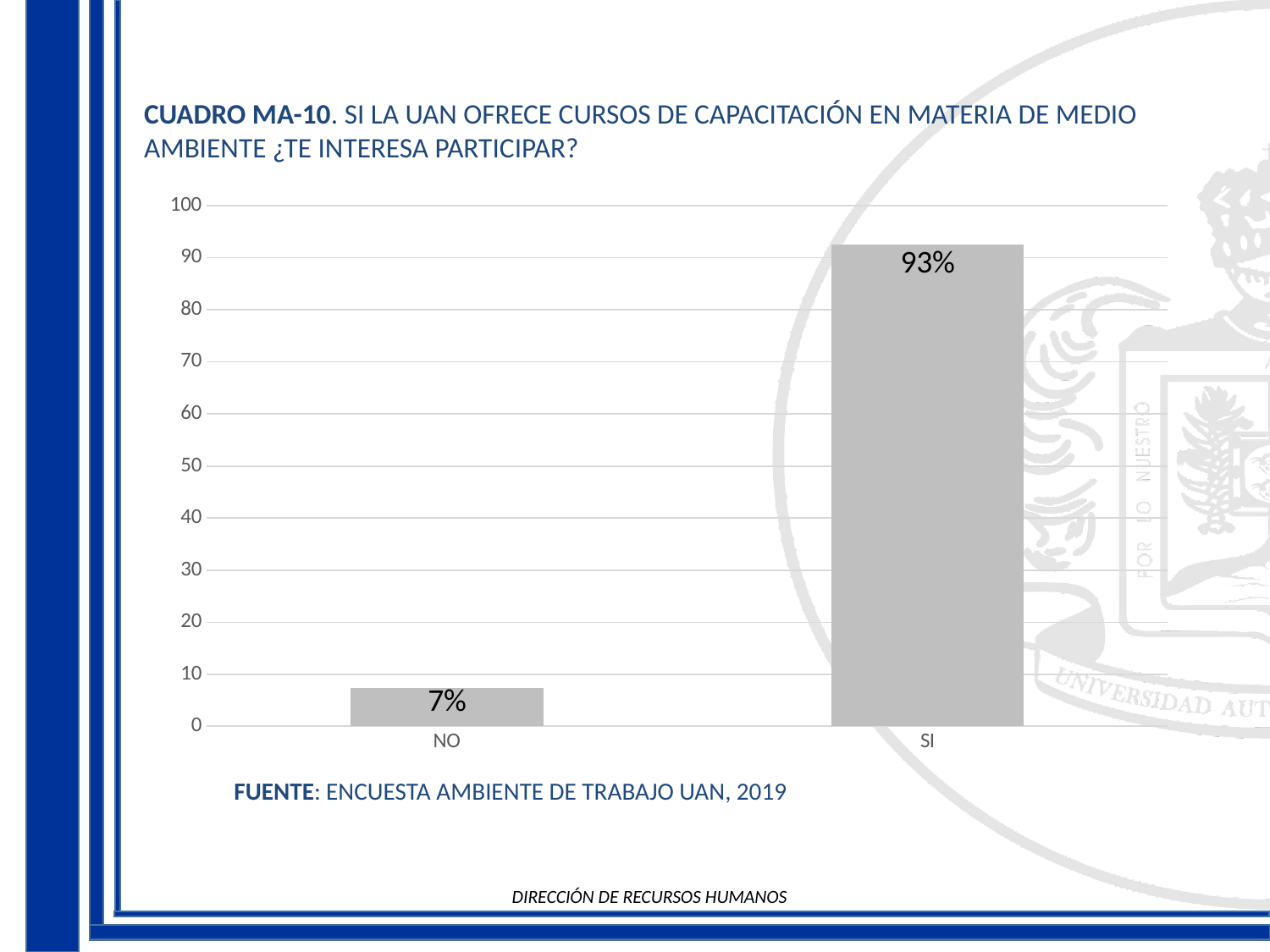
What kind of chart is shown on the slide? bar chart What is the value for SI? 93% How many categories are shown on the x axis? 2 Is the value for SI greater or less than 90? greater Which category has the lowest value? NO Which is larger, the value for SI or the value for NO? SI What is the maximum value shown on the vertical axis? 100 Is the value for NO greater or less than 10? less Which category has the highest value? SI What is the difference between the values for SI and NO? 86% What source is cited below the chart? ENCUESTA AMBIENTE DE TRABAJO UAN, 2019 What is the value for NO? 7%